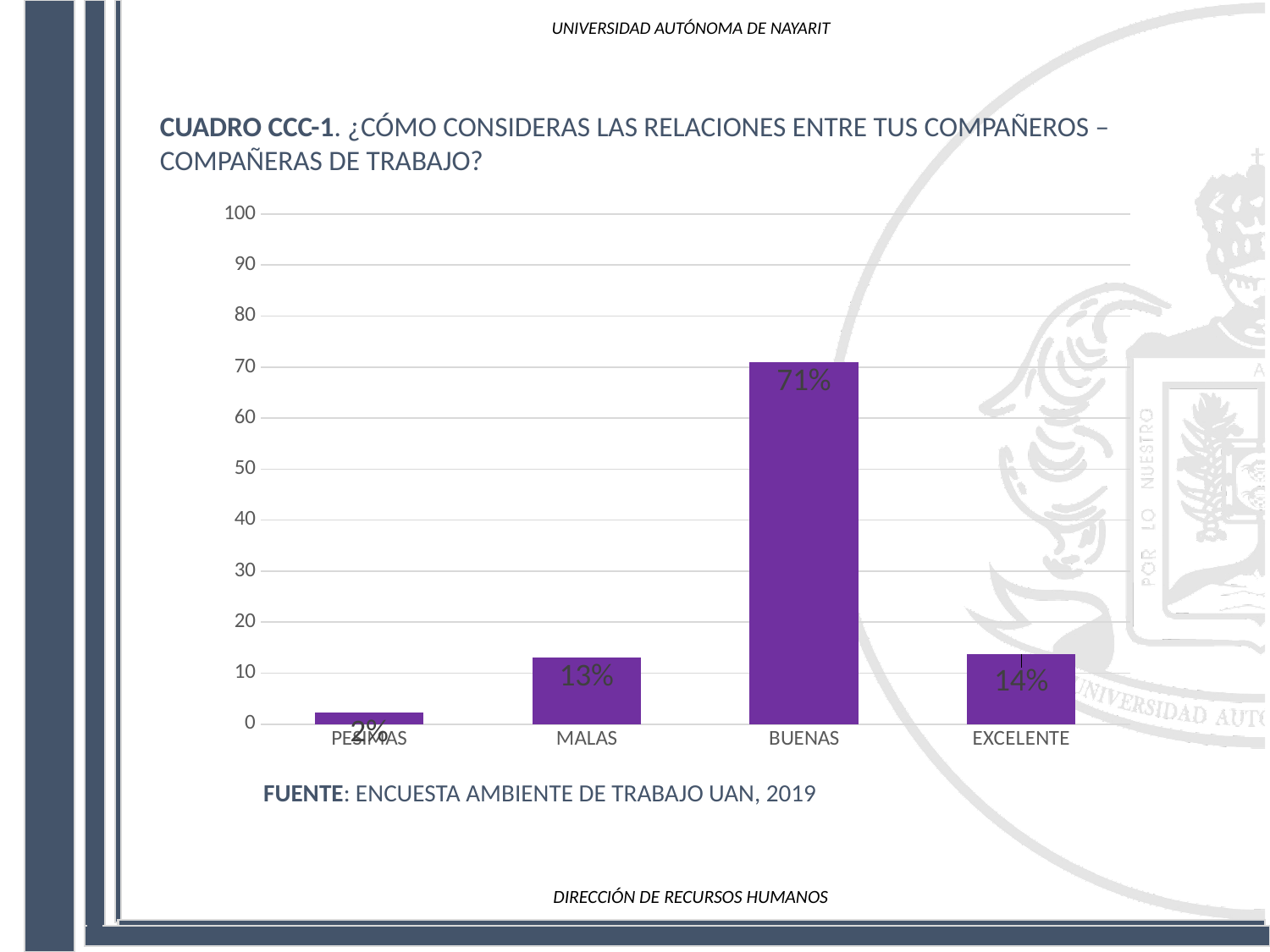
What is the value for BUENAS? 71% Is the value for BUENAS greater or less than 60? greater What type of chart is shown on the slide? bar chart What is the value for MALAS? 13% What is the source cited below the chart? ENCUESTA AMBIENTE DE TRABAJO UAN, 2019 Which category has the highest value? BUENAS How many categories are shown on the x axis of the chart? 4 What is the value for EXCELENTE? 14% Which category has the lowest value? PÉSIMAS What is the value for PÉSIMAS? 2% Which is larger, the value for MALAS or the value for BUENAS? BUENAS What is the difference between the values for BUENAS and EXCELENTE? 57%